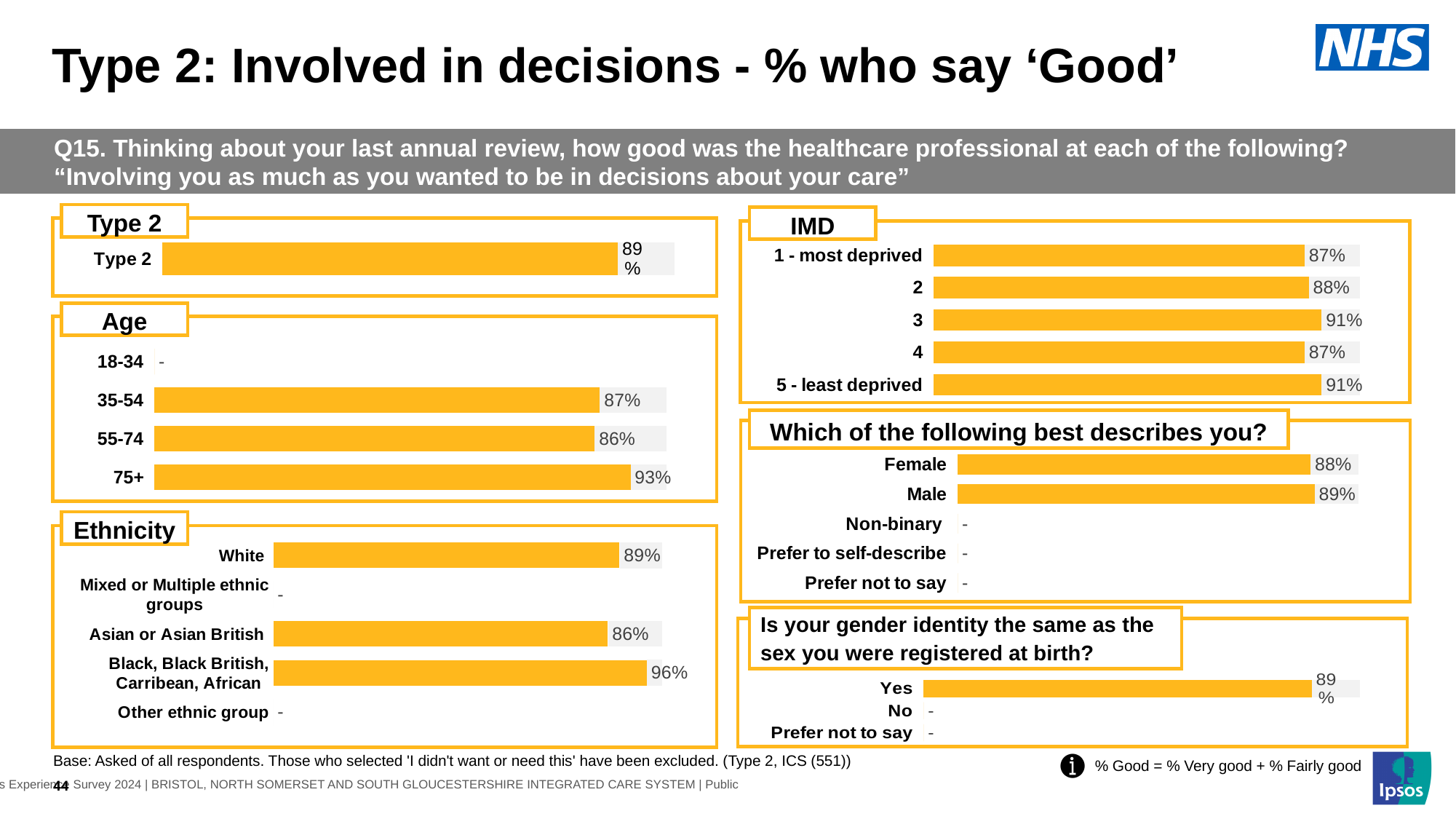
In the Age chart, among the age groups with a value shown, which has the lowest value? 55-74 In the 'Which of the following best describes you?' chart, what is the value for Female? 88% In the Ethnicity chart, which ethnic group has the highest value? Black, Black British, Carribean, African In the IMD chart, which has the larger value, category 3 or category 4? 3 In the Age chart, what is the difference between the values for 75+ and 55-74? 7 percentage points What type of chart is used in the Ethnicity section? Bar chart In the Ethnicity chart, what is the difference between the values for 'Black, Black British, Carribean, African' and 'Asian or Asian British'? 10 percentage points In the IMD chart, what is the value for category 2? 88% In the Type 2 chart, what is the value shown for Type 2? 89% How many categories are shown in the IMD chart? 5 In the 'Is your gender identity the same as the sex you were registered at birth?' chart, what is the value for Yes? 89% In the Age chart, what is the value for the 75+ age group? 93%